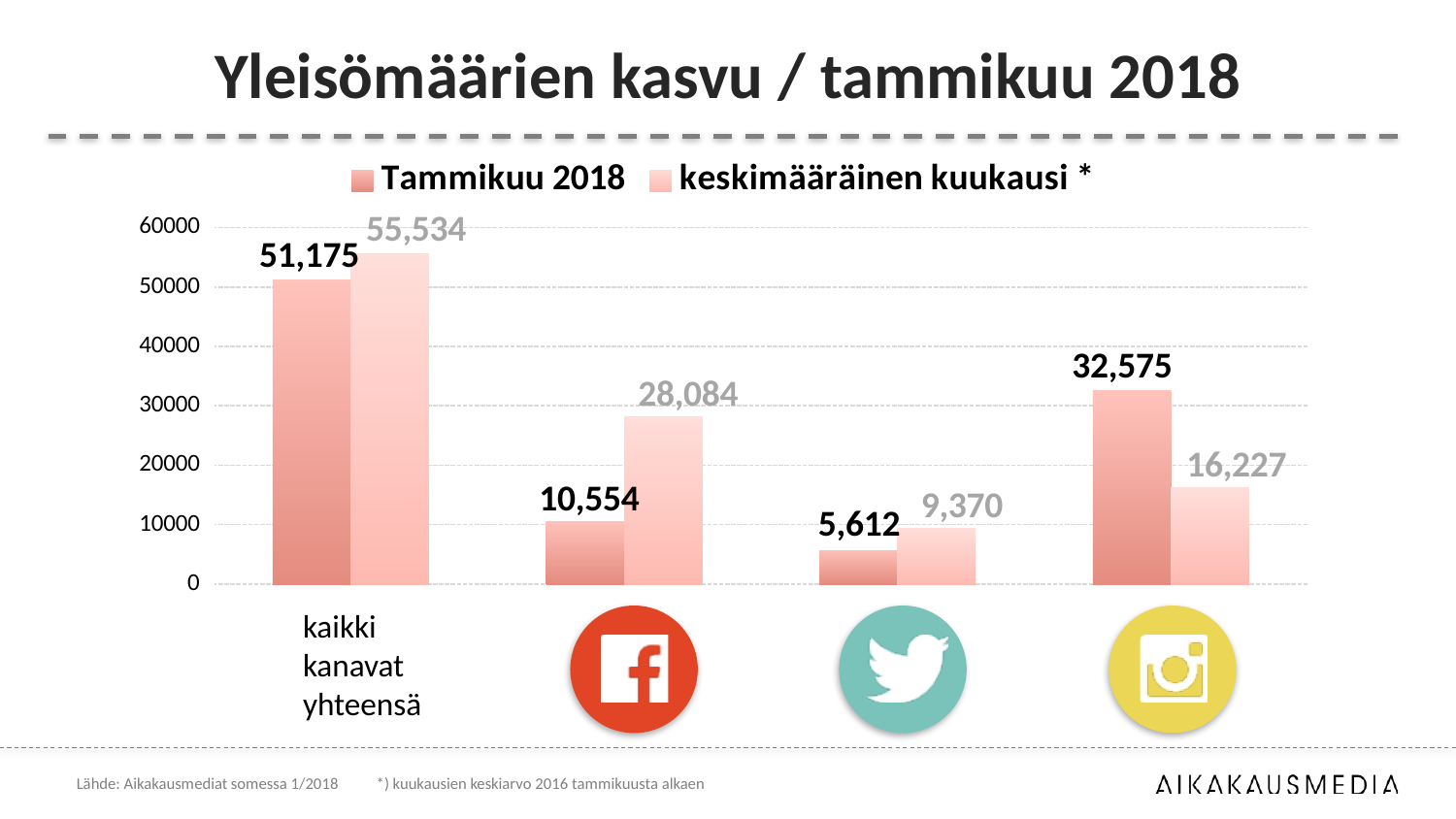
What is the 'keskimääräinen kuukausi *' value for 'kaikki kanavat yhteensä'? 55,534 What is the Tammikuu 2018 value for the category marked with the Twitter icon? 5,612 What is the Tammikuu 2018 value for the category marked with the Instagram icon? 32,575 How many categories are shown along the x axis? 4 What is the Tammikuu 2018 value for 'kaikki kanavat yhteensä'? 51,175 What is the 'keskimääräinen kuukausi *' value for the category marked with the Facebook icon? 28,084 What is the difference between the Tammikuu 2018 value and the 'keskimääräinen kuukausi *' value for the Instagram category? 16,348 What kind of chart is shown on the slide? bar chart Which category has the lowest 'keskimääräinen kuukausi *' value? Twitter For the Facebook category, which is larger: the Tammikuu 2018 value or the 'keskimääräinen kuukausi *' value? keskimääräinen kuukausi * How many series does the legend list? 2 Among the individual channels (Facebook, Twitter, Instagram), which has the highest Tammikuu 2018 value? Instagram